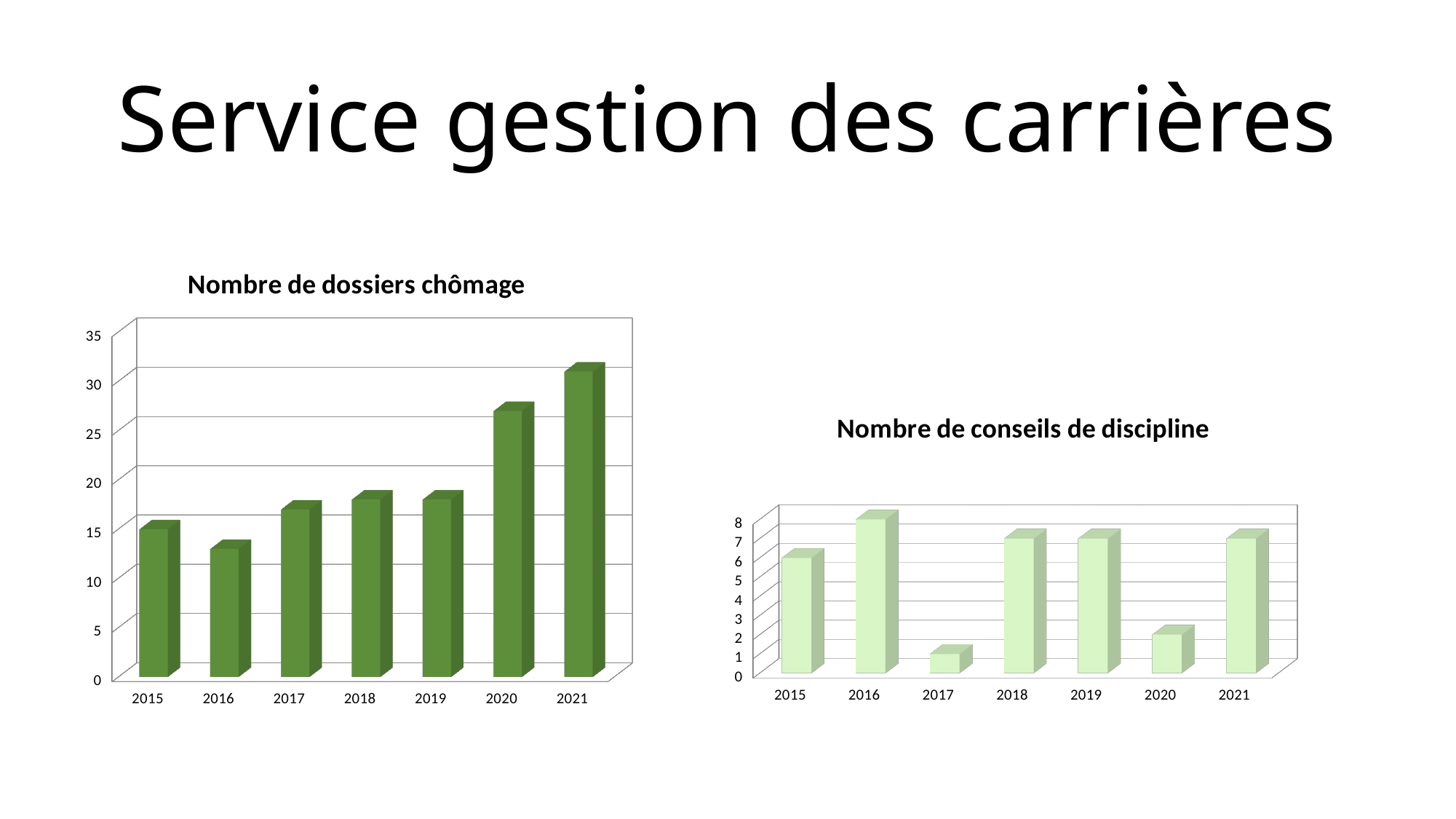
On the 'Nombre de dossiers chômage' chart, is the value for 2016 greater or less than 15? less On the 'Nombre de dossiers chômage' chart, do the values overall rise or fall from 2015 to 2021? rise On the 'Nombre de dossiers chômage' chart, which year has the lowest value? 2016 On the 'Nombre de conseils de discipline' chart, which year has the highest value? 2016 On the 'Nombre de conseils de discipline' chart, is the value for 2020 greater or less than 3? less On the 'Nombre de dossiers chômage' chart, how many years are shown on the x axis? 7 What kind of chart is the 'Nombre de conseils de discipline' chart? bar chart On the 'Nombre de conseils de discipline' chart, which year has the lowest value? 2017 On the 'Nombre de conseils de discipline' chart, which is larger, the value for 2015 or the value for 2016? 2016 On the 'Nombre de dossiers chômage' chart, is the value for 2020 greater or less than 25? greater On the 'Nombre de dossiers chômage' chart, which is larger, the value for 2019 or the value for 2020? 2020 On the 'Nombre de dossiers chômage' chart, which year has the highest value? 2021